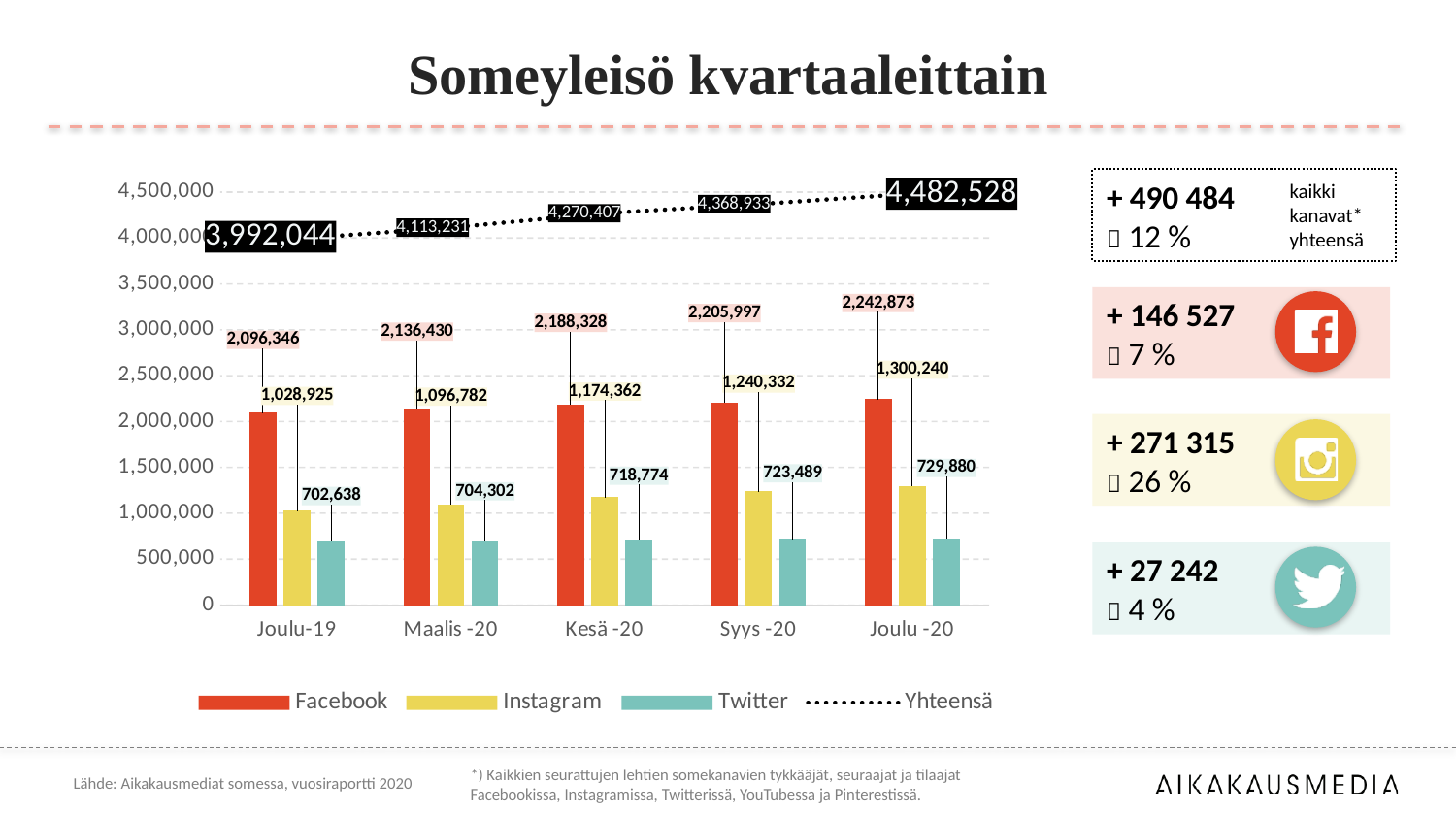
Which is larger in Maalis -20, the Facebook value or the Instagram value? Facebook In which quarter is the Facebook value highest? Joulu -20 In which quarter is the Instagram value lowest? Joulu-19 What is the Yhteensä value for Joulu -20? 4,482,528 How many series does the legend list? 4 How many quarters are shown on the x axis? 5 What is the difference between the Instagram values for Joulu -20 and Joulu-19? 271,315 What is the difference between the Facebook values for Joulu -20 and Joulu-19? 146,527 What is the Twitter value for Syys -20? 723,489 What is the Instagram value for Kesä -20? 1,174,362 Does the Yhteensä line rise or fall from Joulu-19 to Joulu -20? rise What is the Facebook value for Joulu-19? 2,096,346